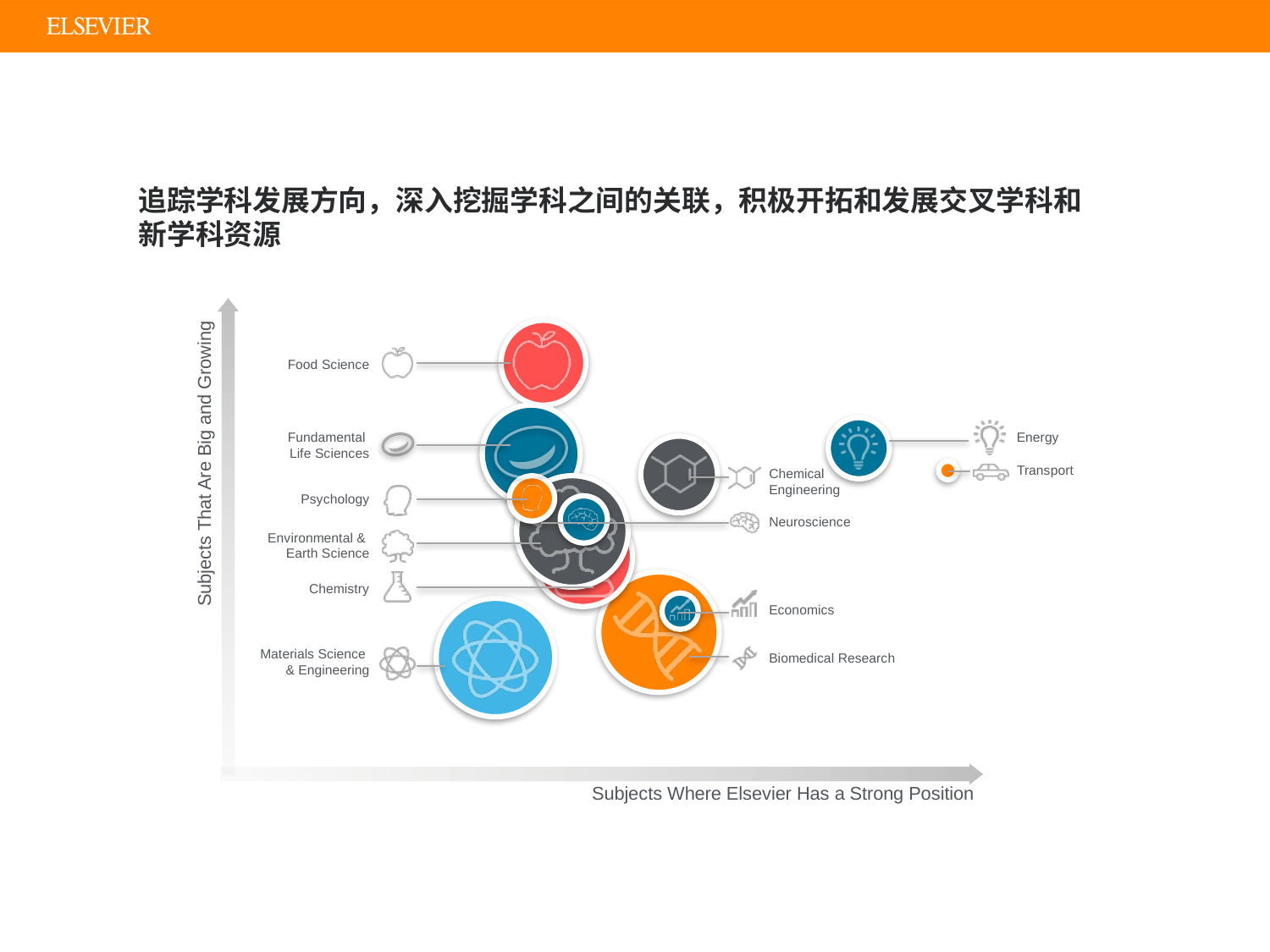
Which subject is plotted highest on the vertical axis? Food Science What kind of chart is shown on the slide? Bubble chart Which subject is plotted furthest to the left on the horizontal axis? Materials Science & Engineering What is the label of the horizontal axis? Subjects Where Elsevier Has a Strong Position Which is plotted higher on the vertical axis, Fundamental Life Sciences or Materials Science & Engineering? Fundamental Life Sciences Which subject has the smallest bubble on the chart? Transport Which is plotted further to the right, Energy or Psychology? Energy Which is plotted higher on the vertical axis, Food Science or Chemistry? Food Science Which subject is plotted furthest to the right on the horizontal axis? Transport How many subjects are plotted on the chart? 12 What is the label of the vertical axis? Subjects That Are Big and Growing